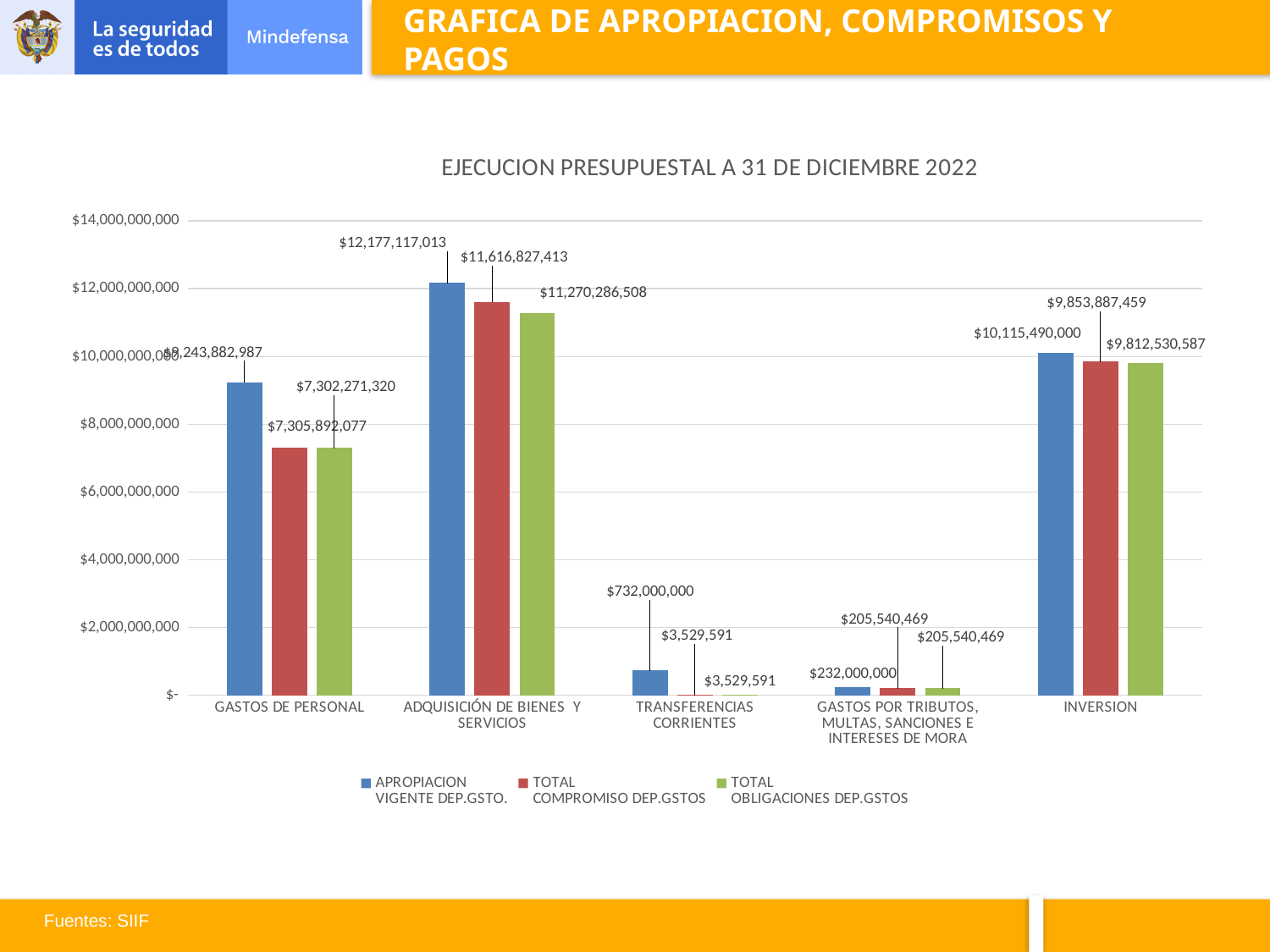
What type of chart is shown on the slide? bar chart What is the TOTAL COMPROMISO DEP.GSTOS value for INVERSION? $9,853,887,459 What is the difference between the APROPIACION VIGENTE DEP.GSTO. and TOTAL COMPROMISO DEP.GSTOS values for ADQUISICIÓN DE BIENES Y SERVICIOS? $560,289,600 How many series does the legend list? 3 What is the APROPIACION VIGENTE DEP.GSTO. value for TRANSFERENCIAS CORRIENTES? $732,000,000 Which category has the highest APROPIACION VIGENTE DEP.GSTO. value? ADQUISICIÓN DE BIENES Y SERVICIOS Which category has the larger TOTAL COMPROMISO DEP.GSTOS value, INVERSION or ADQUISICIÓN DE BIENES Y SERVICIOS? ADQUISICIÓN DE BIENES Y SERVICIOS Which category has the lowest APROPIACION VIGENTE DEP.GSTO. value? GASTOS POR TRIBUTOS, MULTAS, SANCIONES E INTERESES DE MORA What is the APROPIACION VIGENTE DEP.GSTO. value for ADQUISICIÓN DE BIENES Y SERVICIOS? $12,177,117,013 What is the TOTAL OBLIGACIONES DEP.GSTOS value for GASTOS DE PERSONAL? $7,302,271,320 Is the APROPIACION VIGENTE DEP.GSTO. value for GASTOS DE PERSONAL greater or less than $10,000,000,000? less How many categories are shown on the x axis of the chart? 5